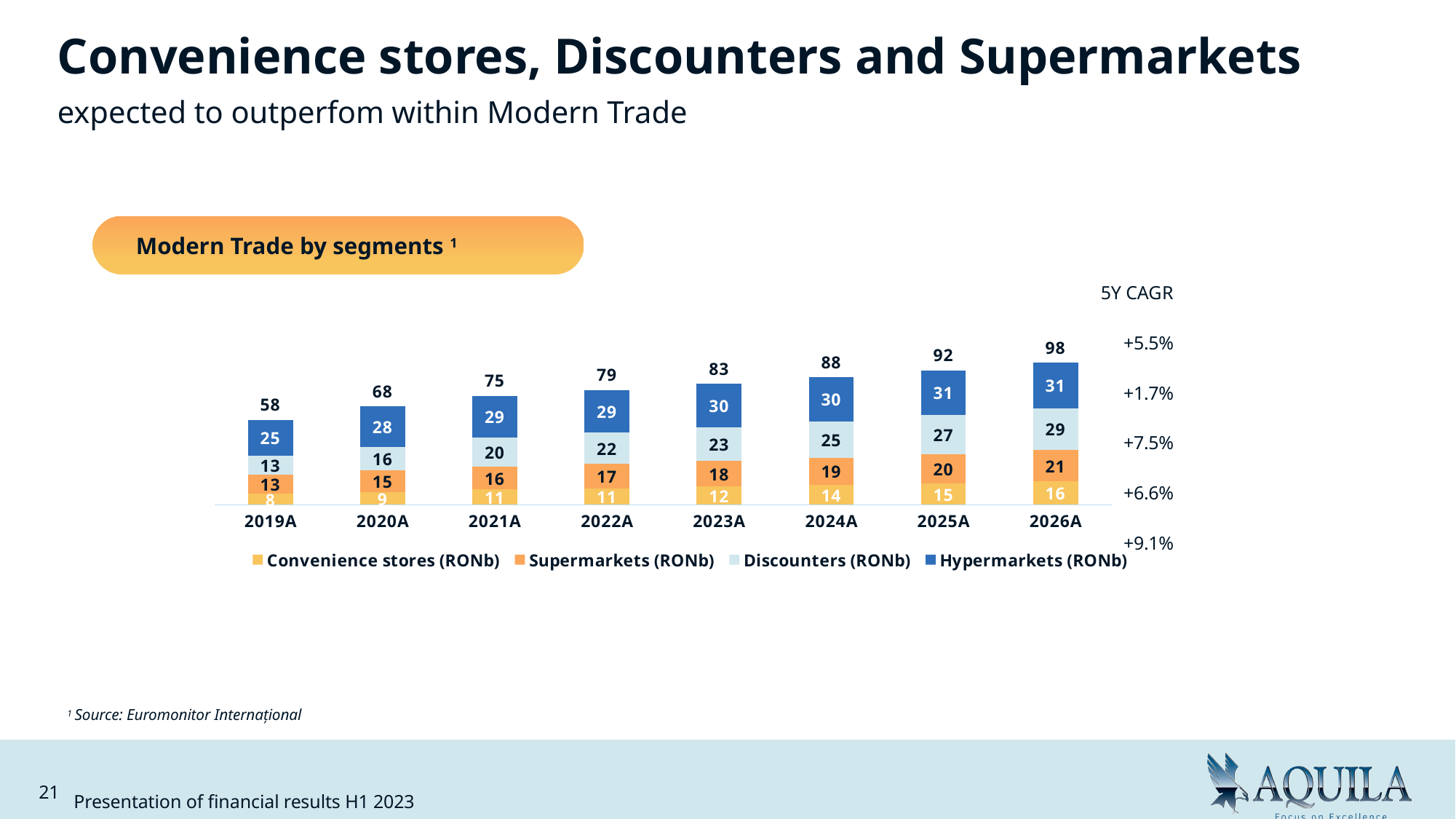
What type of chart is shown on the slide? Stacked bar chart Which year has the lowest total Modern Trade value? 2019A What is the total of the stacked bar for 2024A? 88 Which year has the highest total Modern Trade value? 2026A What is the value for Convenience stores (RONb) in 2026A? 16 Do the total values rise or fall from 2019A to 2026A? Rise How many years are shown on the x axis? 8 What is the value for Hypermarkets (RONb) in 2019A? 25 How many series does the legend list? 4 What is the value for Discounters (RONb) in 2023A? 23 Which is larger in 2021A: Discounters (RONb) or Supermarkets (RONb)? Discounters (RONb) What is the difference between the Supermarkets (RONb) value in 2026A and in 2019A? 8